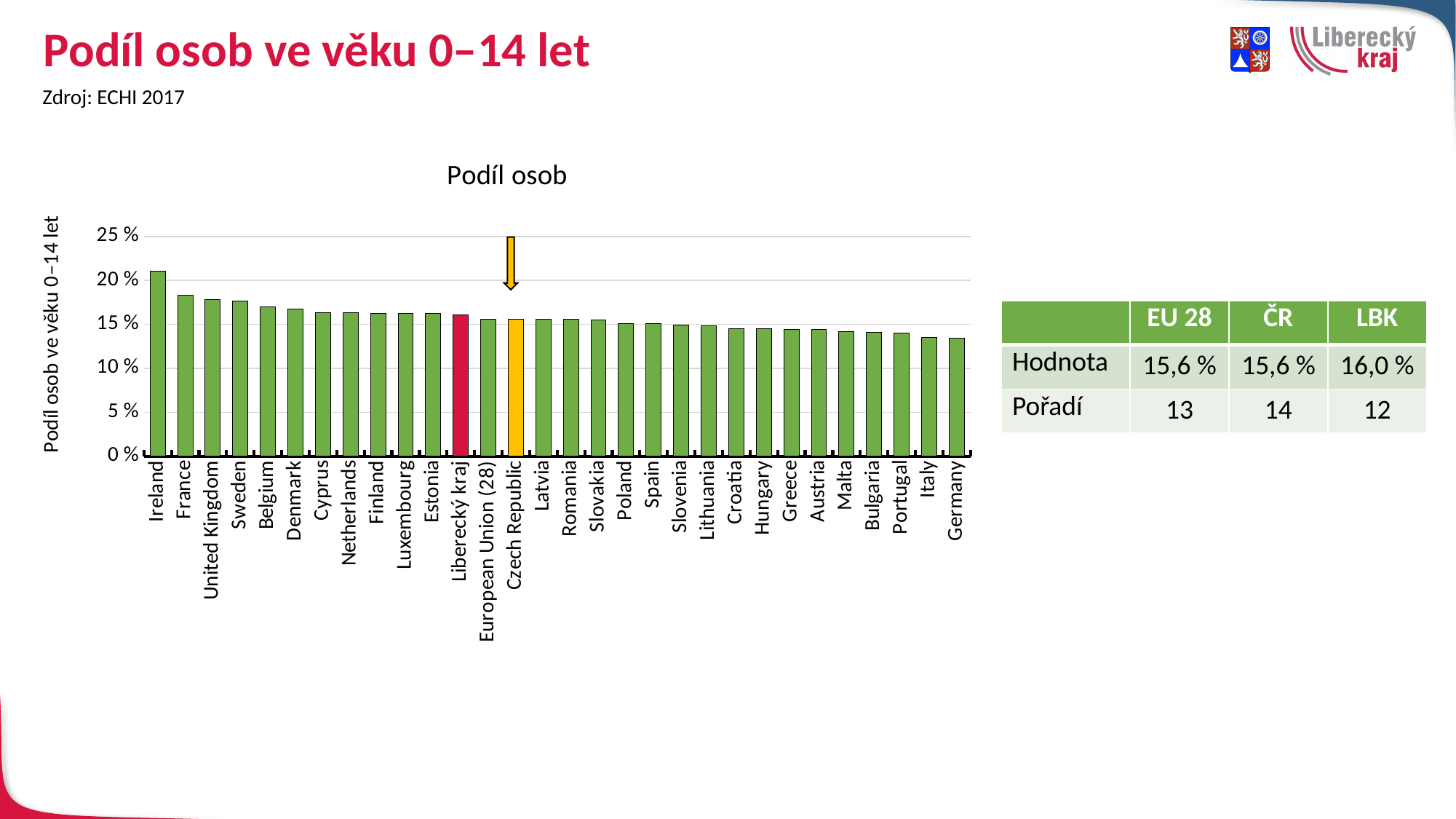
Do the values rise or fall from left to right along the x axis? fall How many bars (categories) are plotted in the chart? 30 Is the value for Ireland greater or less than 15 %? greater Which bar in the chart is coloured red? Liberecký kraj Which category has the highest value in the chart? Ireland Is the value for France greater or less than 20 %? less What kind of chart is shown on the slide? bar chart What is the title of the chart? Podíl osob According to the table next to the chart, what is the value (Hodnota) for LBK? 16,0 % Is the value for Germany greater or less than 15 %? less Which has the larger value, Sweden or Germany? Sweden Which has the larger value, Ireland or France? Ireland